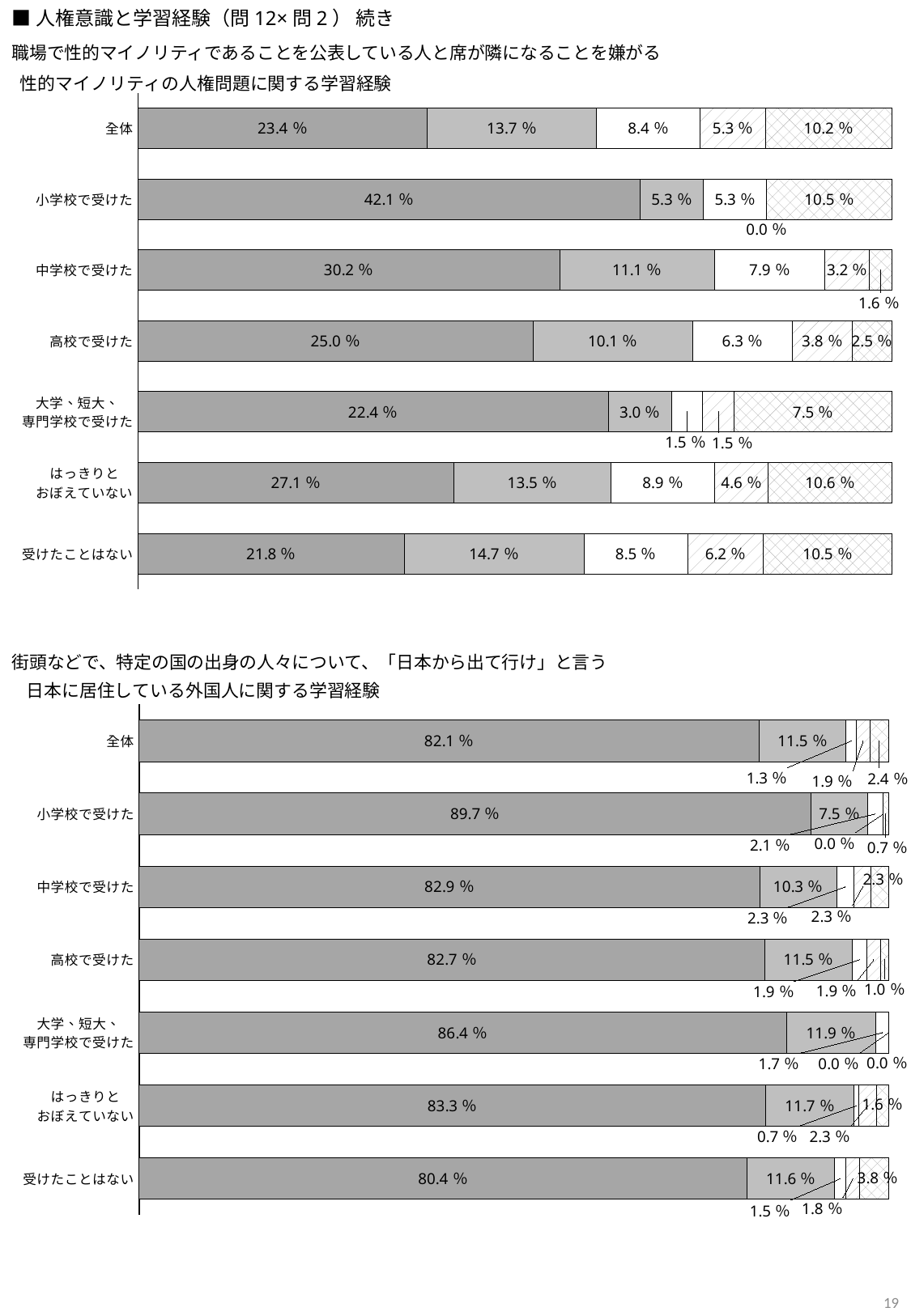
In the top chart (性的マイノリティの人権問題に関する学習経験), what is the value of the rightmost (cross-hatched) segment for 全体? 10.2 % In the bottom chart (日本に居住している外国人に関する学習経験), what is the value of the second (light grey) segment for 中学校で受けた? 10.3 % In the top chart (性的マイノリティの人権問題に関する学習経験), what is the value of the leftmost (dark grey) segment for 高校で受けた? 25.0 % What is the title of the bottom chart on the slide? 日本に居住している外国人に関する学習経験 In the top chart (性的マイノリティの人権問題に関する学習経験), which category has the largest leftmost (dark grey) segment? 小学校で受けた What kind of chart is the top chart (性的マイノリティの人権問題に関する学習経験)? Stacked horizontal bar chart In the bottom chart (日本に居住している外国人に関する学習経験), which category has the smallest leftmost (dark grey) segment? 受けたことはない How many categories are shown in the bottom chart (日本に居住している外国人に関する学習経験)? 7 In the bottom chart (日本に居住している外国人に関する学習経験), what is the difference between the leftmost segment values for 小学校で受けた and 受けたことはない? 9.3 % In the top chart (性的マイノリティの人権問題に関する学習経験), which has the larger leftmost segment value: 小学校で受けた or 中学校で受けた? 小学校で受けた In the top chart (性的マイノリティの人権問題に関する学習経験), what is the difference between the leftmost segment values for 小学校で受けた and 全体? 18.7 % In the bottom chart (日本に居住している外国人に関する学習経験), what is the value of the leftmost (dark grey) segment for 大学、短大、専門学校で受けた? 86.4 %